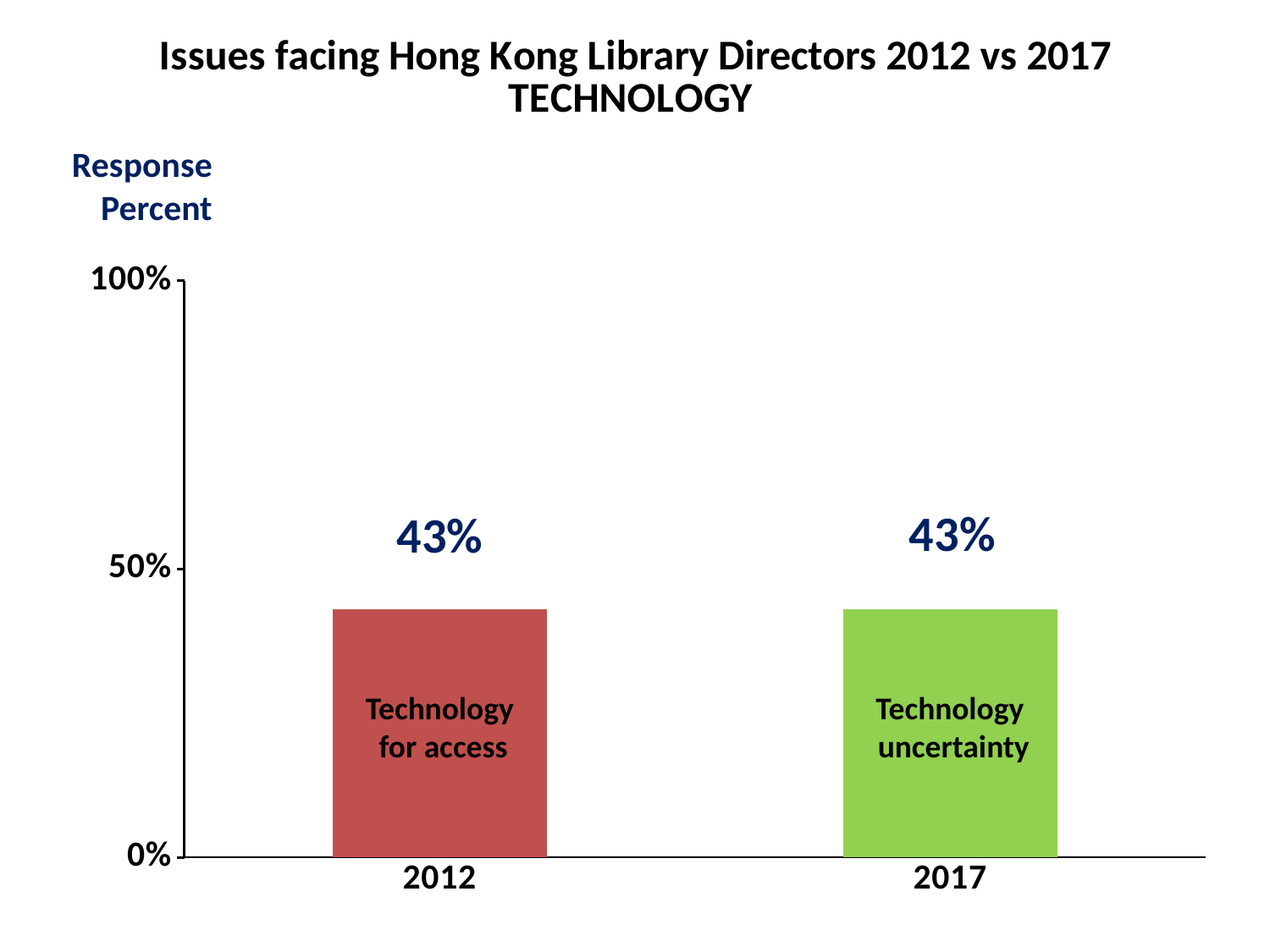
What is the label of the vertical axis? Response Percent How many bars are shown in the chart? 2 What is the title of the chart? Issues facing Hong Kong Library Directors 2012 vs 2017 TECHNOLOGY What is the highest value shown on the vertical axis? 100% Is the value for 2012 greater or less than 50%? less What is the difference between the values for 2012 and 2017? 0% What label is written inside the 2012 bar? Technology for access What kind of chart is shown on the slide? bar chart Is the value for 2017 greater or less than 50%? less What is the value for 2012? 43% What is the value for 2017? 43%